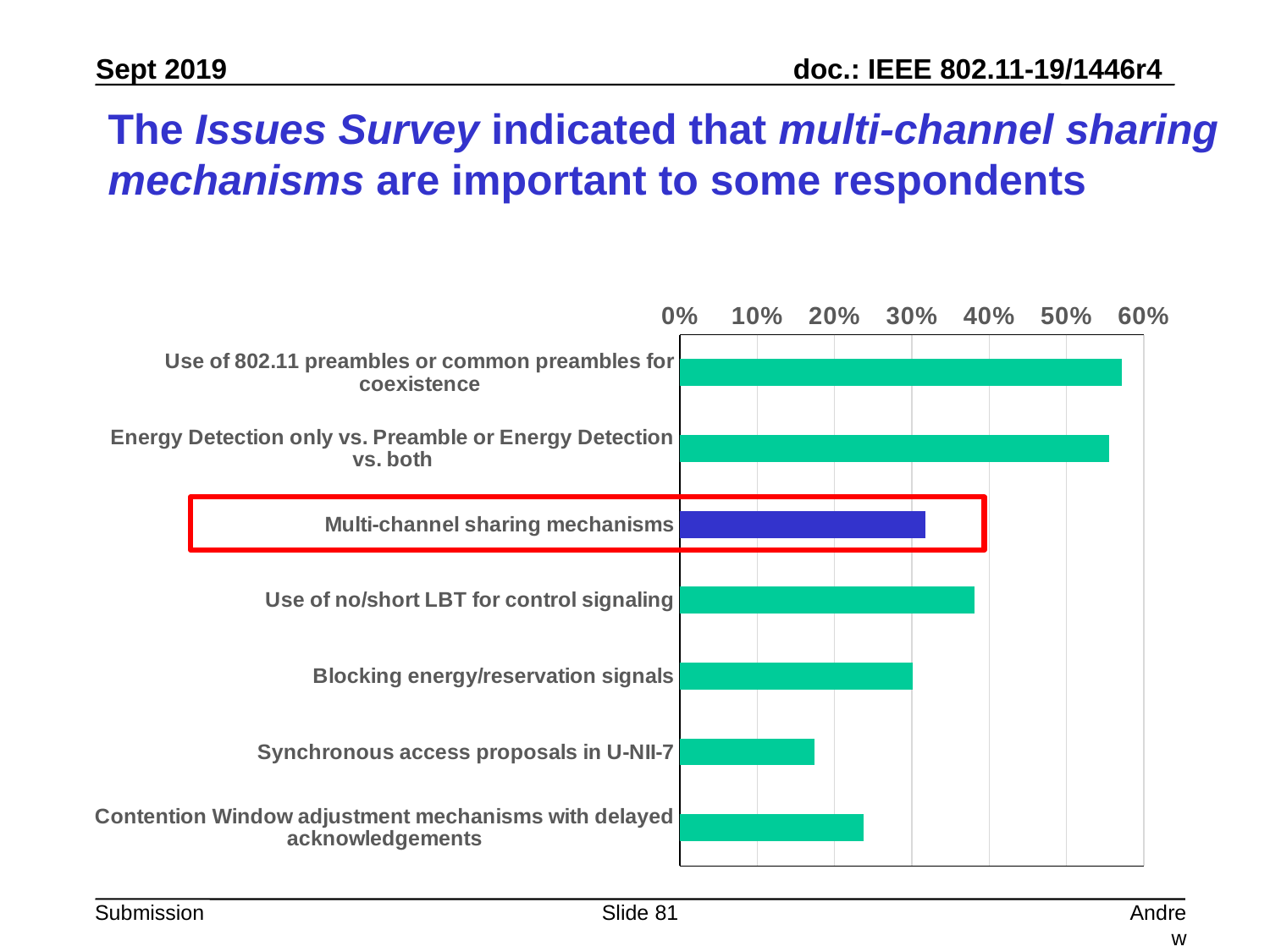
Is the value for Contention Window adjustment mechanisms with delayed acknowledgements greater or less than 20%? greater Which category has the lowest value in the chart? Synchronous access proposals in U-NII-7 Which has a larger value: Blocking energy/reservation signals or Contention Window adjustment mechanisms with delayed acknowledgements? Blocking energy/reservation signals Which has a larger value: Use of no/short LBT for control signaling or Multi-channel sharing mechanisms? Use of no/short LBT for control signaling What is the highest value shown on the percentage axis of the chart? 60% Which category's bar is drawn in a different colour (blue) from the others? Multi-channel sharing mechanisms Is the value for Synchronous access proposals in U-NII-7 greater or less than 20%? less What kind of chart is shown on the slide? bar chart Is the value for Use of no/short LBT for control signaling greater or less than 40%? less How many categories are plotted in the chart? 7